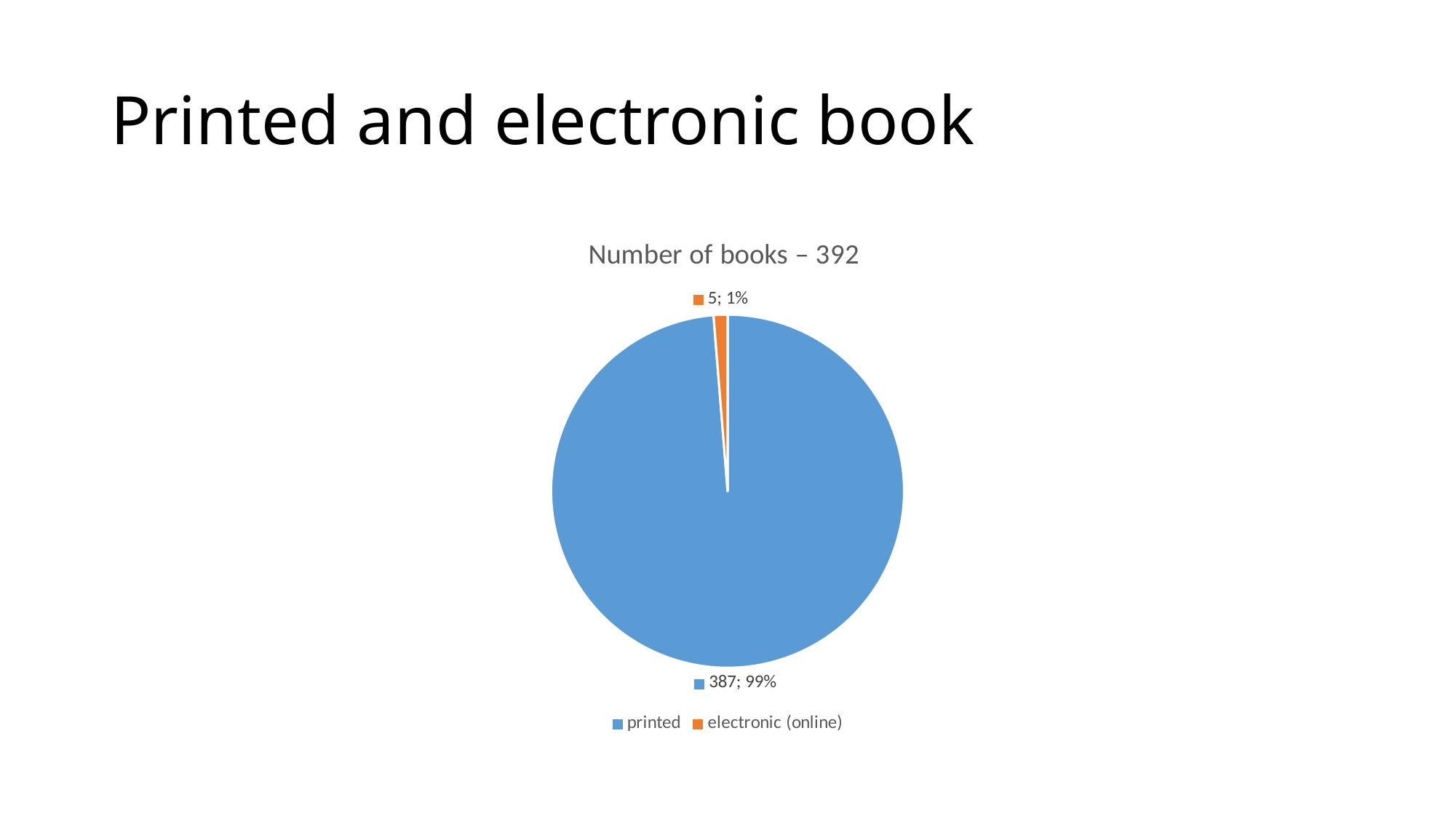
How many categories does the pie chart have? 2 Which category has the smallest slice? electronic (online) What kind of chart is shown on the slide? pie chart Which category has the largest slice? printed What share of the pie is the electronic (online) slice? 1% How many books are printed? 387 What is the difference between the number of printed books and electronic (online) books? 382 What is the title of the chart? Number of books – 392 Which is larger, the printed slice or the electronic (online) slice? printed What colour is the electronic (online) slice? orange How many books are electronic (online)? 5 What share of the pie is the printed slice? 99%